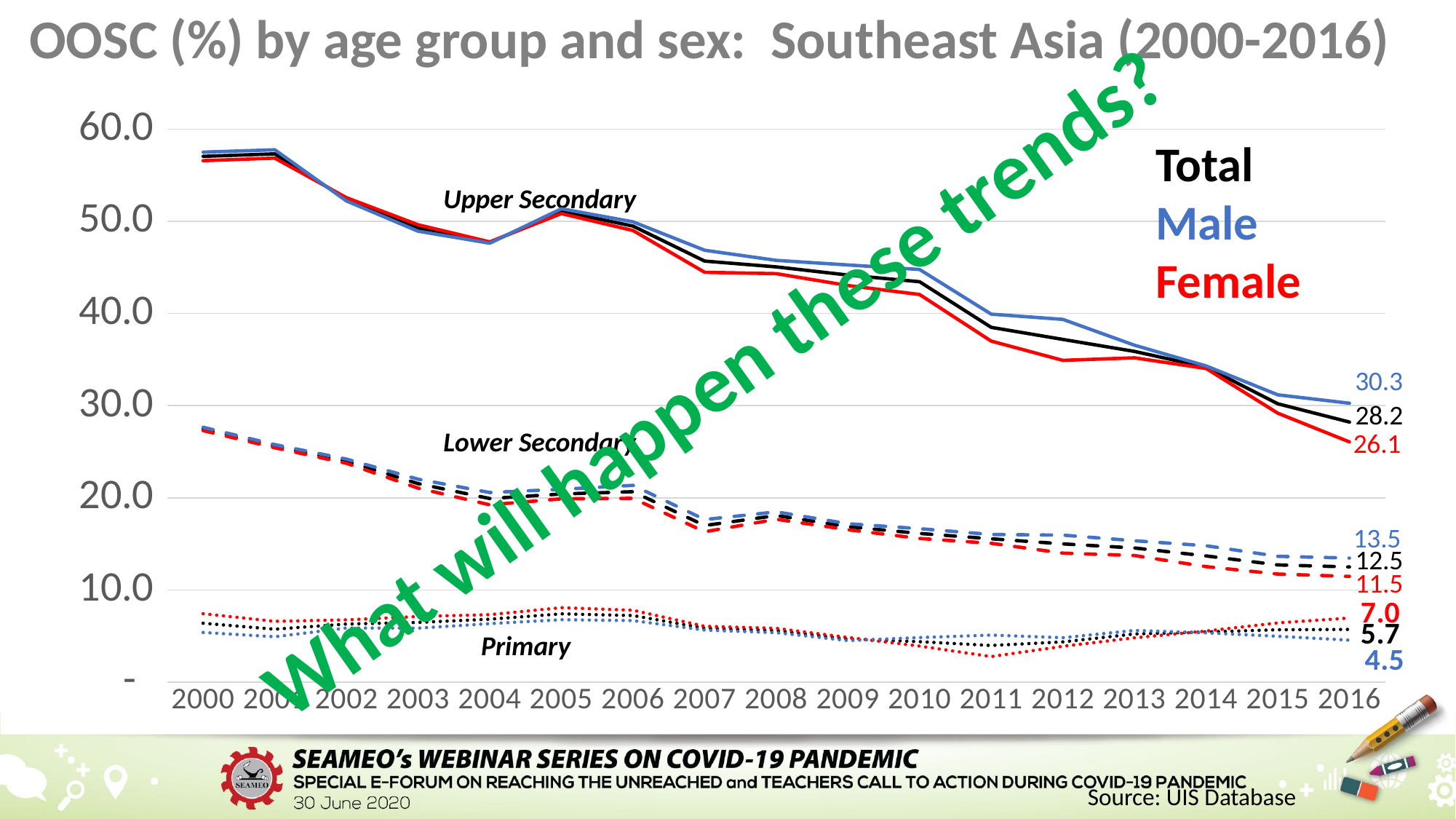
Is the Upper Secondary Total value in 2000 greater or less than 50.0? greater What is the Upper Secondary Female OOSC value in 2016? 26.1 In 2016, which is larger for Primary: the Male value or the Female value? Female What is the Primary Male OOSC value in 2016? 4.5 What is the difference between the Lower Secondary Male and Female values in 2016? 2.0 What is the Primary Female OOSC value in 2016? 7.0 What type of chart is shown on the slide? line chart What is the Upper Secondary Male OOSC value in 2016? 30.3 How does the Upper Secondary OOSC rate change from 2000 to 2016? It falls How many years are shown on the x axis? 17 What is the difference between the Upper Secondary Male and Female values in 2016? 4.2 What is the Lower Secondary Total OOSC value in 2016? 12.5